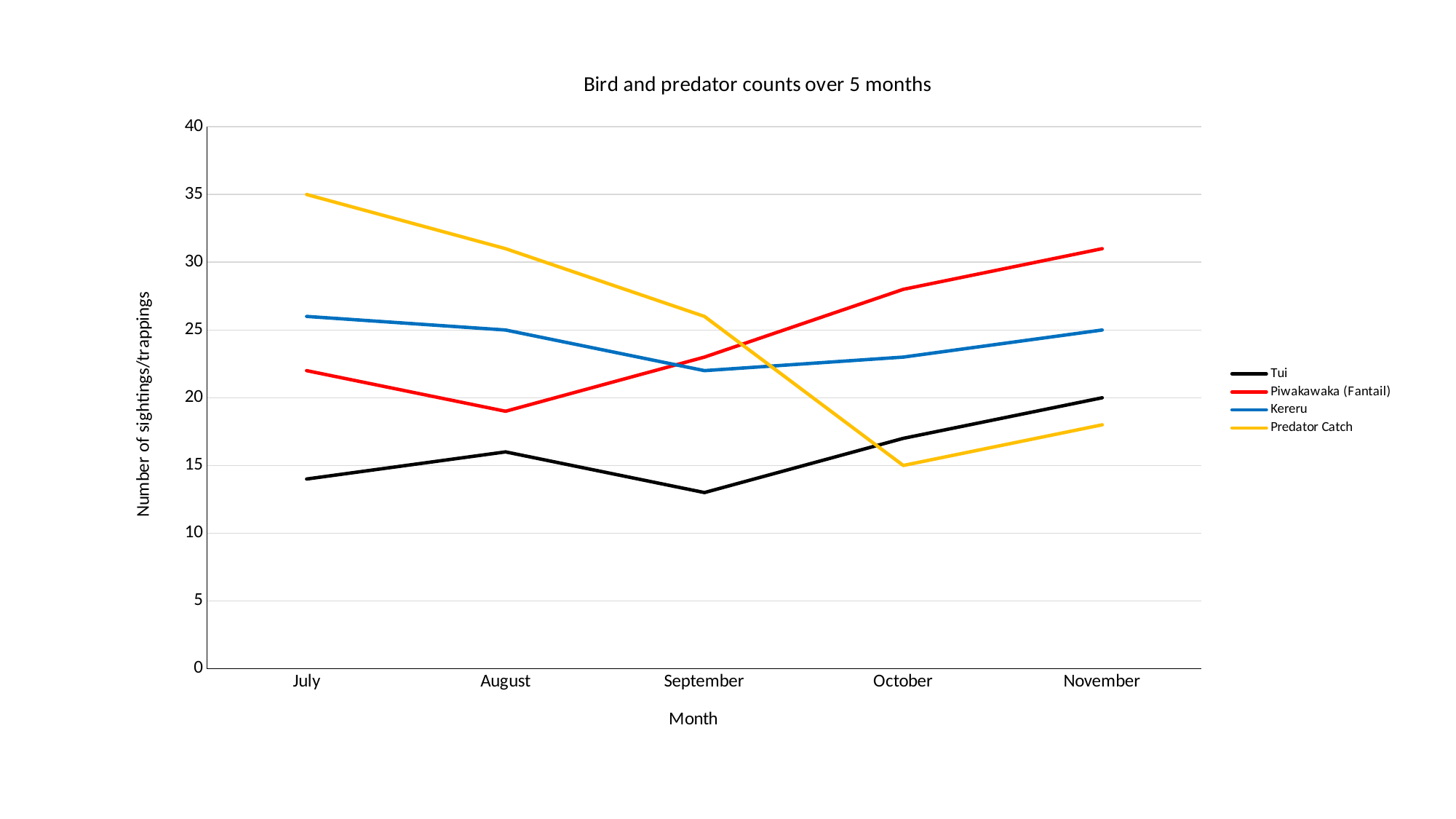
What is the difference between the Predator Catch values for July and October? 20 What kind of chart is shown on the slide? line chart What is the Kereru value for November? 25 How many series does the legend list? 4 In which month is the Tui count lowest? September What is the Tui value for November? 20 What is the Predator Catch value for October? 15 In which month is the Piwakawaka (Fantail) count highest? November Does the Predator Catch line rise or fall from July to October? fall What is the Predator Catch value for July? 35 Is the Tui value for September greater or less than 15? less How many months are plotted along the x axis? 5